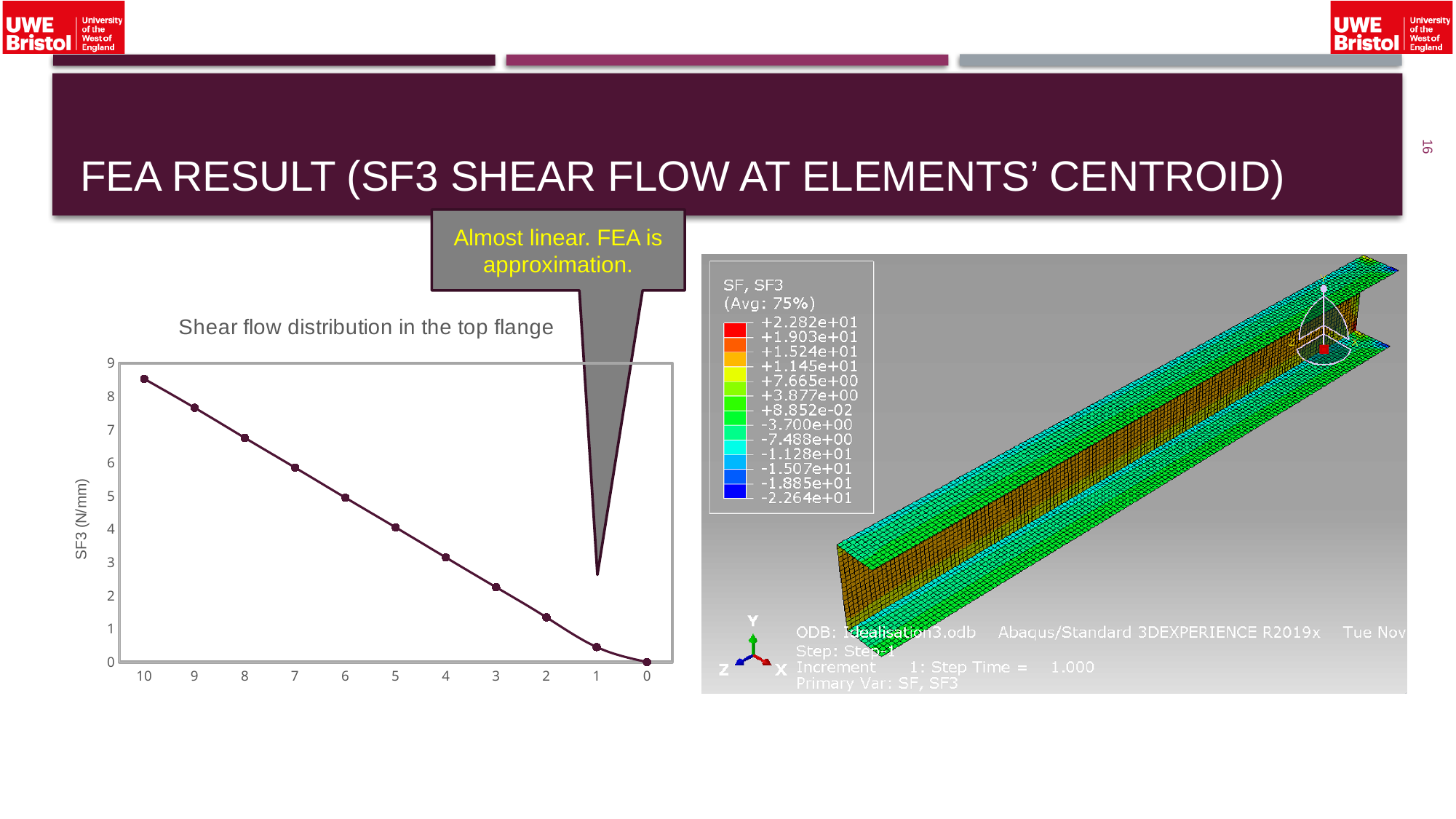
In the 'Shear flow distribution in the top flange' chart, at which x-axis position is SF3 lowest? 0 In the 'Shear flow distribution in the top flange' chart, at which x-axis position is SF3 highest? 10 In the 'Shear flow distribution in the top flange' chart, is the SF3 value at x = 1 greater or less than 1? less What is the label on the vertical axis of the 'Shear flow distribution in the top flange' chart? SF3 (N/mm) What does the callout pointing at the 'Shear flow distribution in the top flange' chart say? Almost linear. FEA is approximation. What kind of chart is 'Shear flow distribution in the top flange'? line chart In the 'Shear flow distribution in the top flange' chart, which has the larger SF3 value: x = 9 or x = 3? 9 In the 'Shear flow distribution in the top flange' chart, is the SF3 value at x = 7 greater or less than 5? greater In the 'Shear flow distribution in the top flange' chart, is the SF3 value at x = 8 greater or less than 7? less In the 'Shear flow distribution in the top flange' chart, do the values rise or fall moving from left to right along the x axis? fall How many data points are plotted in the 'Shear flow distribution in the top flange' chart? 11